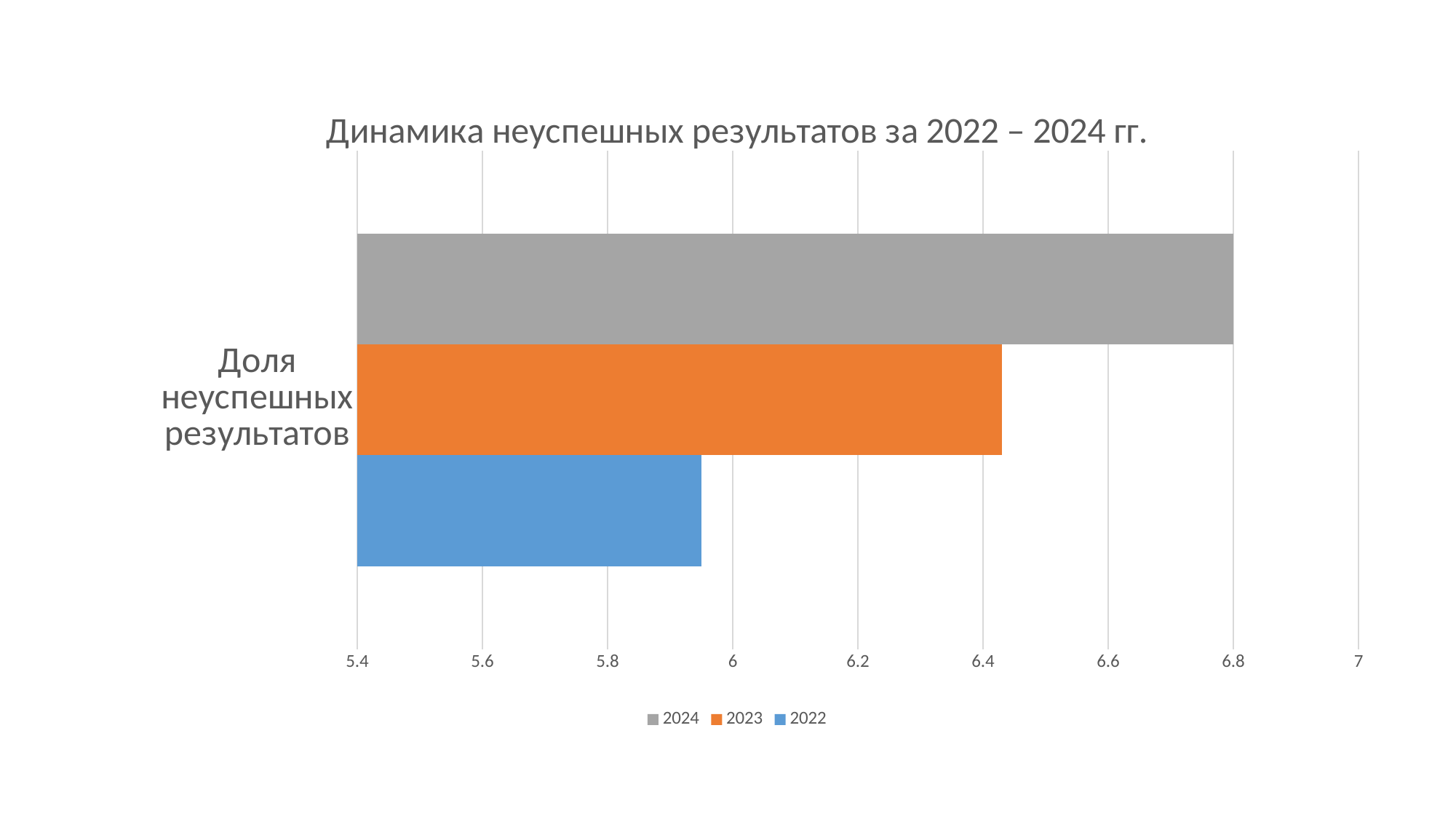
Which year has the lowest value for Доля неуспешных результатов? 2022 Which year has the highest value for Доля неуспешных результатов? 2024 What is the title of the chart? Динамика неуспешных результатов за 2022 – 2024 гг. How many series does the legend list? 3 Is the value for 2022 greater or less than 6? less Which years are listed in the legend? 2024, 2023, 2022 What kind of chart is shown on the slide? bar chart Is the value for 2023 greater or less than 6.4? greater How many categories are shown on the vertical axis? 1 What is the value for 2024 for Доля неуспешных результатов? 6.8 Which is larger, the value for 2023 or the value for 2022? 2023 Do the values rise or fall from 2022 to 2024? rise